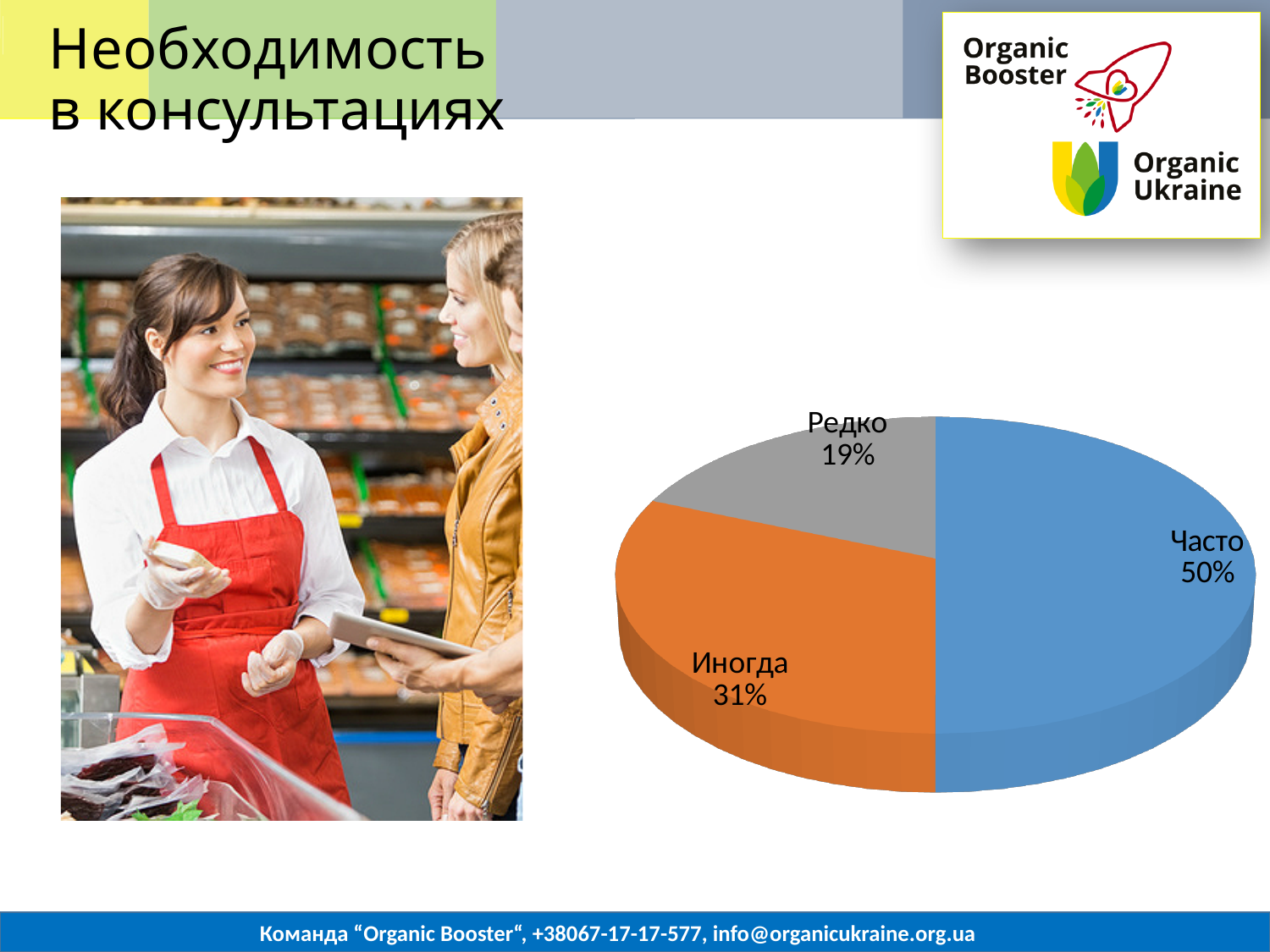
Which category has the largest slice of the pie? Часто What colour is the "Редко" slice of the pie? grey Which category has the smallest slice of the pie? Редко Which slice is larger, "Иногда" or "Редко"? Иногда What share of the pie does the "Редко" slice represent? 19% How many slices does the pie chart have? 3 What is the difference in percentage points between the "Иногда" and "Редко" slices? 12% What kind of chart is shown on the slide? pie chart What is the difference in percentage points between the "Часто" and "Иногда" slices? 19% What share of the pie does the "Часто" slice represent? 50% What colour is the "Часто" slice of the pie? blue What share of the pie does the "Иногда" slice represent? 31%